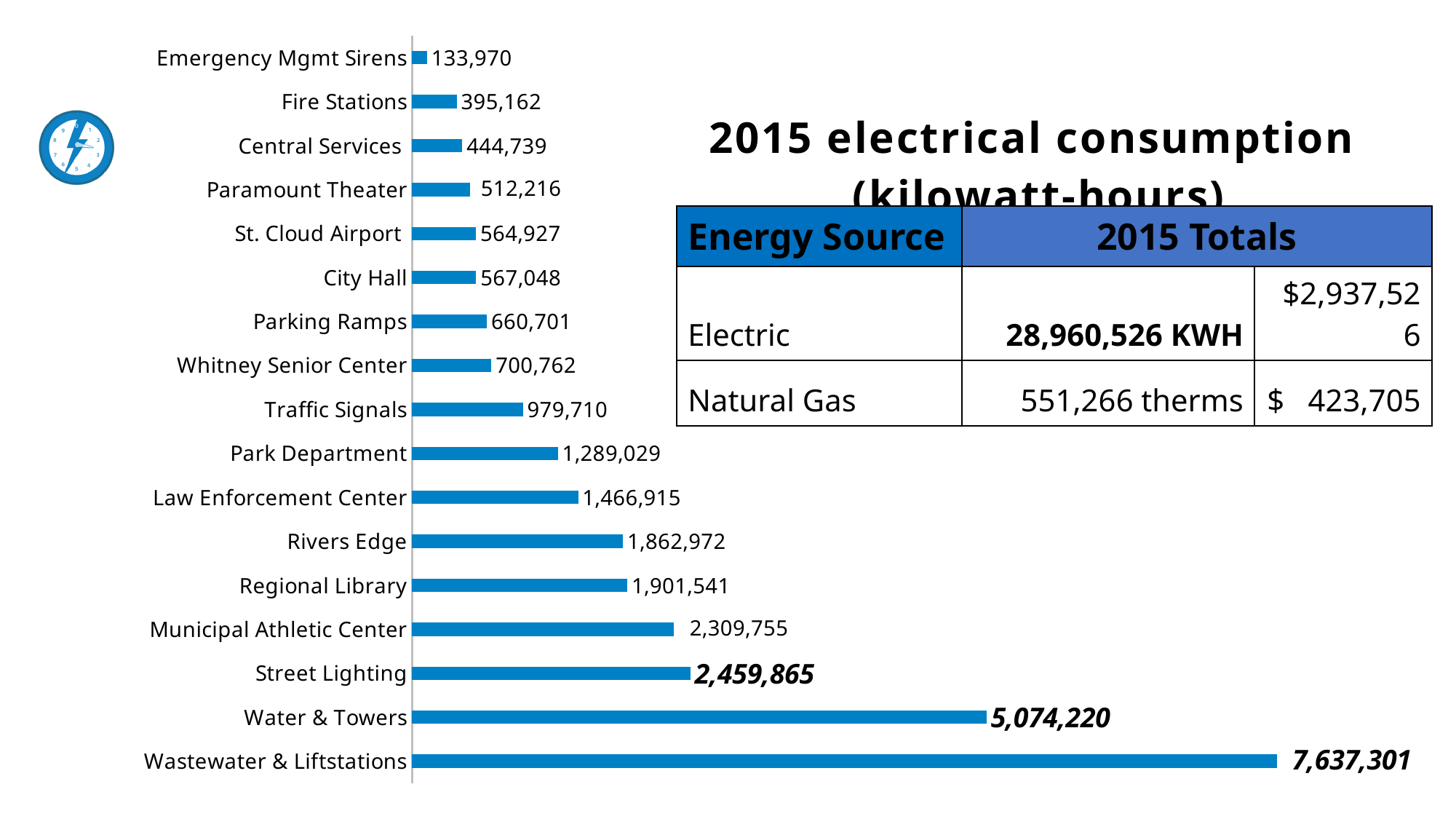
What kind of chart is shown on the slide? Bar chart Which category has the lowest value? Emergency Mgmt Sirens What is the difference between the values for Wastewater & Liftstations and Water & Towers? 2,563,081 Which is larger, the value for Traffic Signals or the value for Whitney Senior Center? Traffic Signals What is the value for Wastewater & Liftstations? 7,637,301 What is the value for Regional Library? 1,901,541 Which category has the highest value? Wastewater & Liftstations What colour are the bars in the chart? Blue What is the value for Traffic Signals? 979,710 What is the value for Parking Ramps? 660,701 What is the difference between the values for Street Lighting and Municipal Athletic Center? 150,110 How many categories are shown in the bar chart? 17